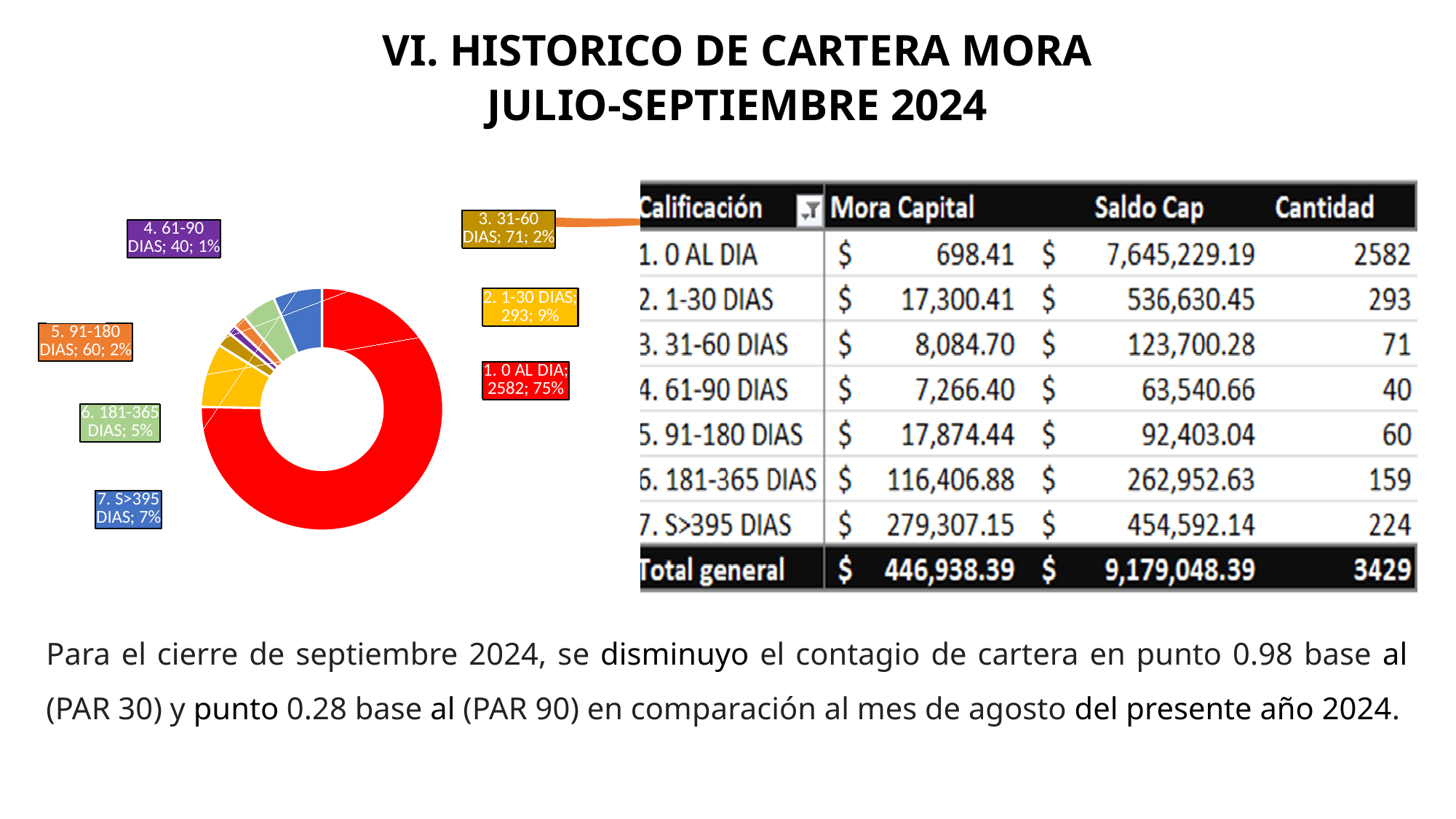
What is the value shown for the slice "3. 31-60 DIAS" in the doughnut chart? 71 Which slice of the doughnut chart is the smallest? 4. 61-90 DIAS What share of the doughnut chart does the slice "1. 0 AL DIA" represent? 75% What kind of chart is shown on the left of the slide? Doughnut (pie) chart In the doughnut chart, what is the difference between the values for "2. 1-30 DIAS" and "3. 31-60 DIAS"? 222 What share of the doughnut chart does the slice "7. S>395 DIAS" represent? 7% In the doughnut chart, which slice has the larger value: "5. 91-180 DIAS" or "4. 61-90 DIAS"? 5. 91-180 DIAS What is the value shown for the slice "2. 1-30 DIAS" in the doughnut chart? 293 How many categories (slices) does the doughnut chart have? 7 What is the value shown for the slice "5. 91-180 DIAS" in the doughnut chart? 60 Which slice of the doughnut chart is the largest? 1. 0 AL DIA What share of the doughnut chart does the slice "4. 61-90 DIAS" represent? 1%